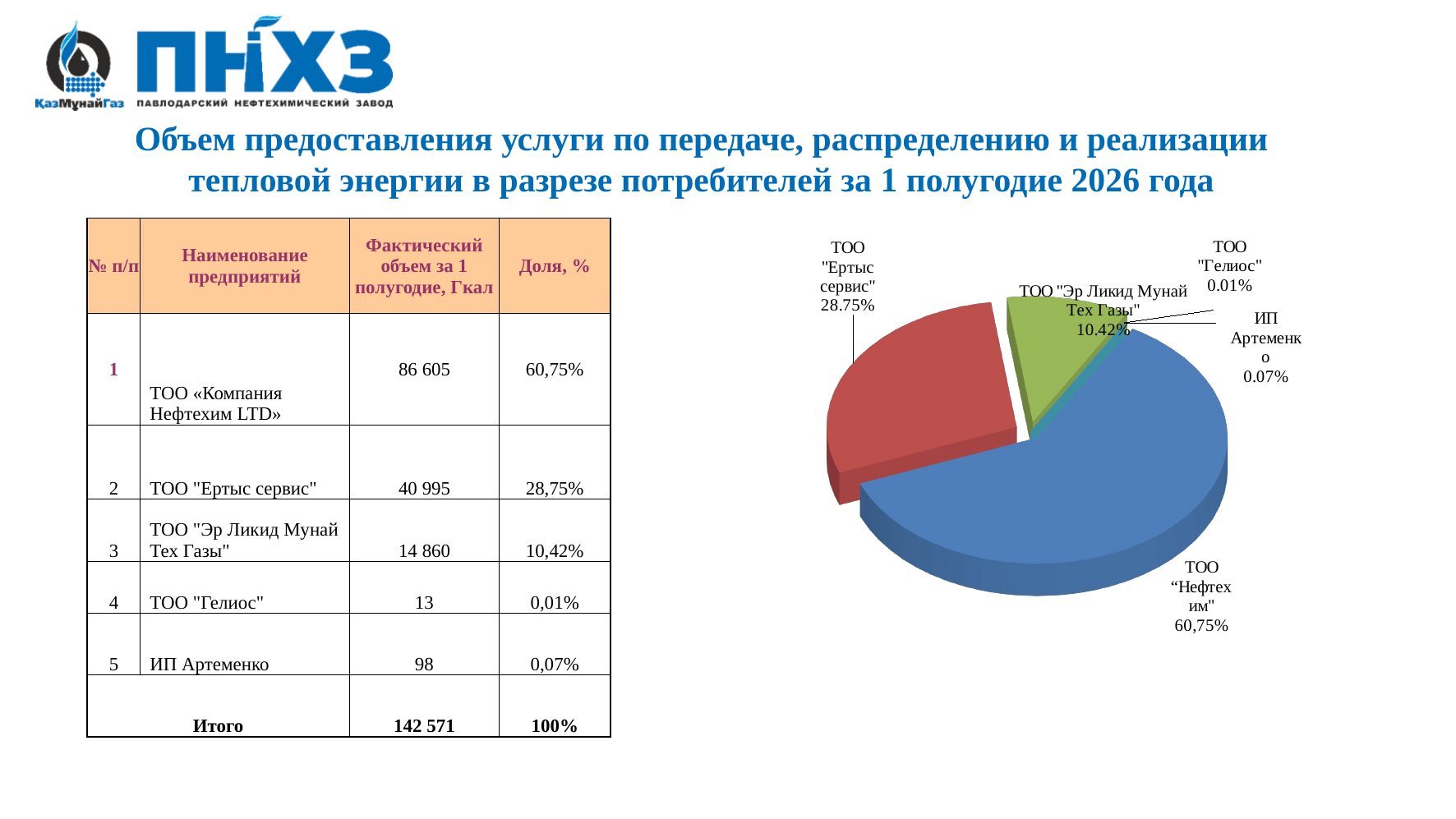
Which slice of the pie chart is the smallest? ТОО "Гелиос" What colour is the largest slice of the pie chart? blue What kind of chart is shown on the slide? pie chart What share of the pie chart does ТОО "Нефтехим" have? 60,75% In the pie chart, which is larger: ТОО "Ертыс сервис" or ТОО "Эр Ликид Мунай Тех Газы"? ТОО "Ертыс сервис" What share of the pie chart does ТОО "Гелиос" have? 0.01% How many slices does the pie chart have? 5 In the pie chart, what is the difference in percentage points between the shares of ТОО "Ертыс сервис" and ТОО "Эр Ликид Мунай Тех Газы"? 18.33 What share of the pie chart does ТОО "Ертыс сервис" have? 28.75% Which slice of the pie chart is the largest? ТОО "Нефтехим"